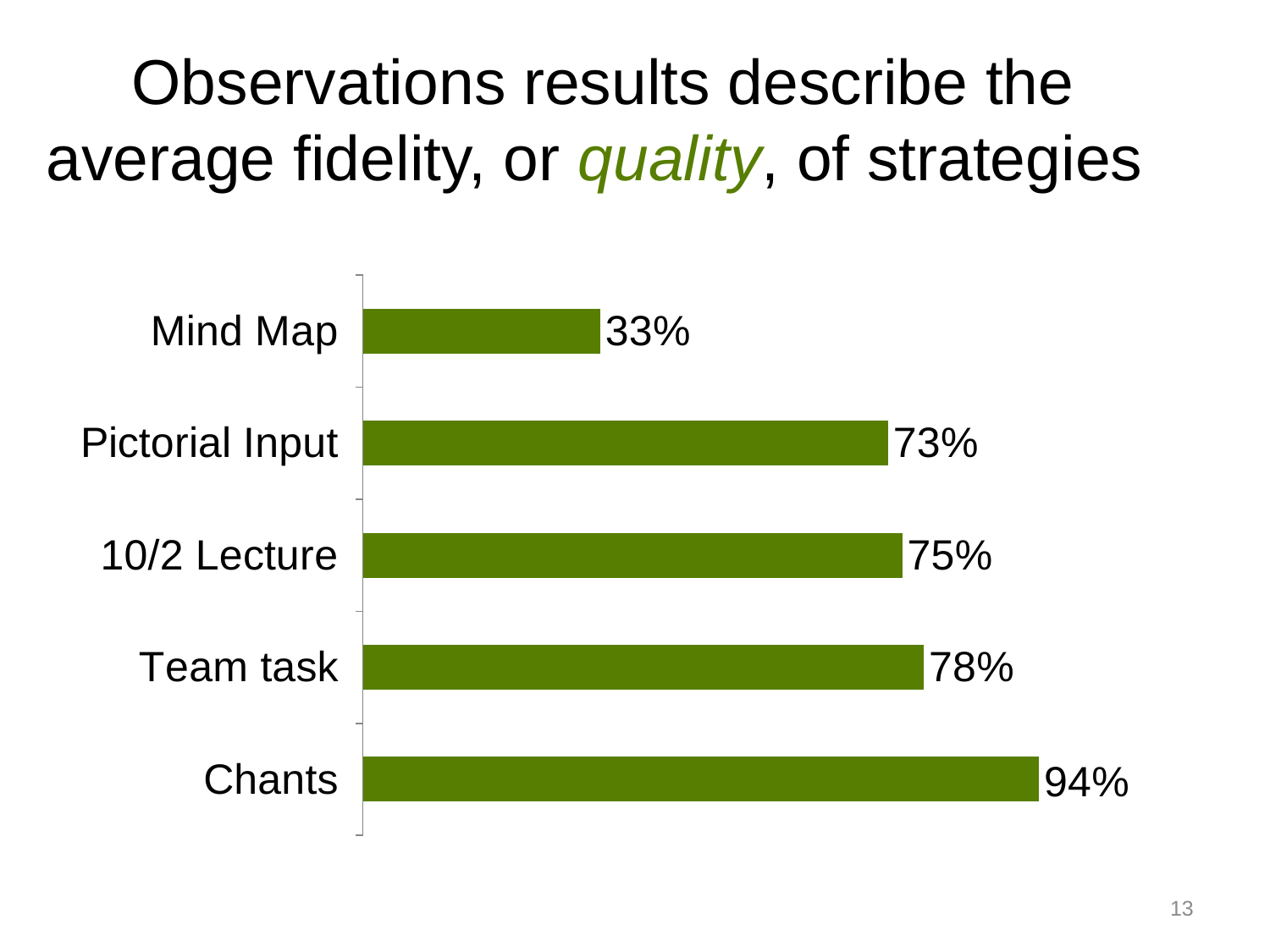
What is the difference between the values for Team task and Pictorial Input? 5% What is the value for Pictorial Input? 73% How many strategies are shown in the chart? 5 What is the value for Chants? 94% What is the difference between the values for Chants and Mind Map? 61% What colour are the bars in the chart? Green Which strategy has the lowest value? Mind Map What is the value for 10/2 Lecture? 75% Which is larger, the value for Team task or the value for Pictorial Input? Team task Which strategy has the highest value? Chants What kind of chart is shown on the slide? Bar chart What is the value for Mind Map? 33%